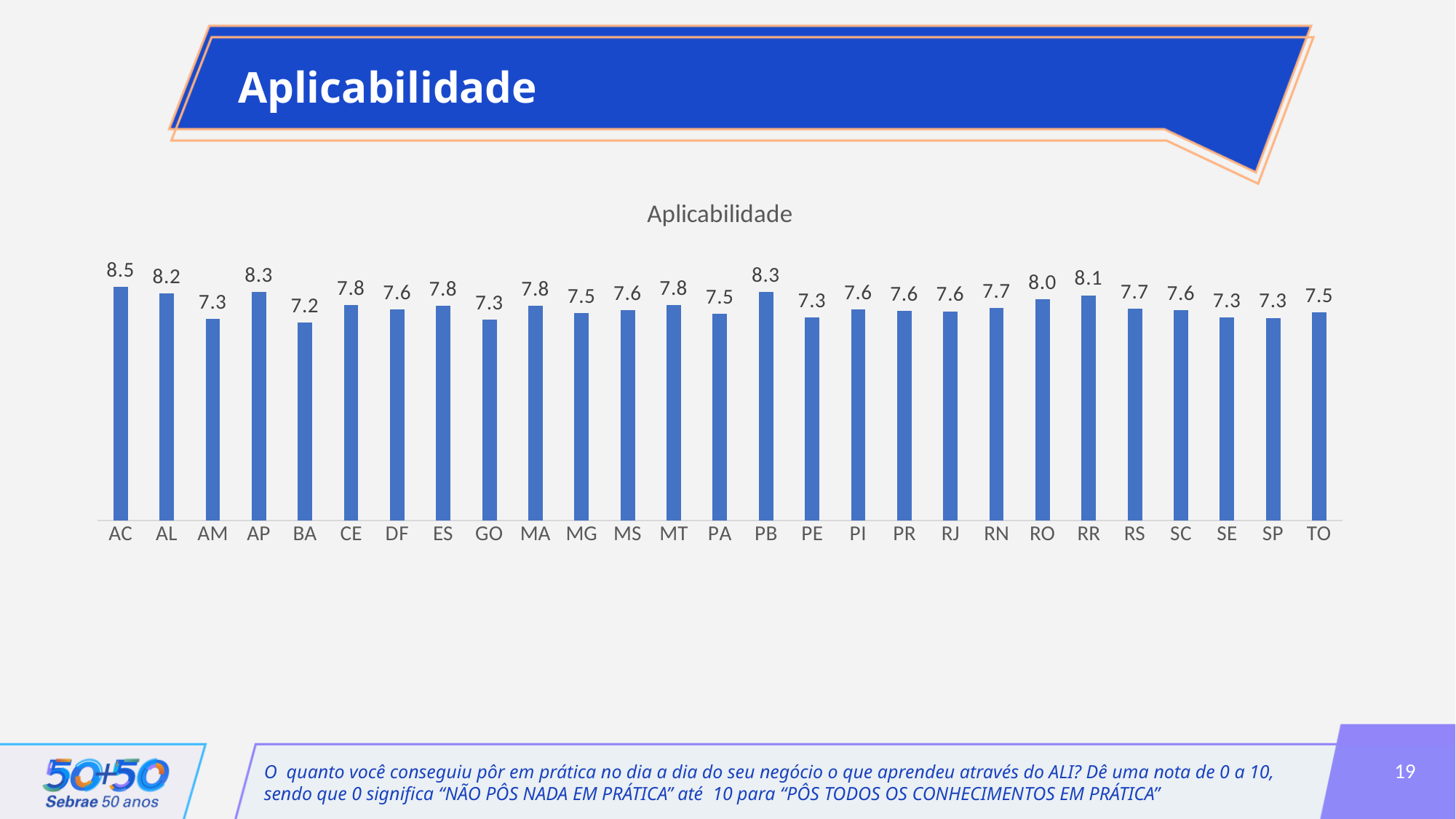
Which is larger, the value for AL or the value for RO? AL How many categories are shown on the x axis? 27 Which category has the lowest value? BA What is the value for RO? 8.0 What is the value for AC? 8.5 What is the value for PB? 8.3 What is the difference between the values for AC and BA? 1.3 What kind of chart is this? Bar chart Which category has the highest value? AC What is the value for SP? 7.3 What is the title of the chart? Aplicabilidade What is the difference between the values for RR and RN? 0.4